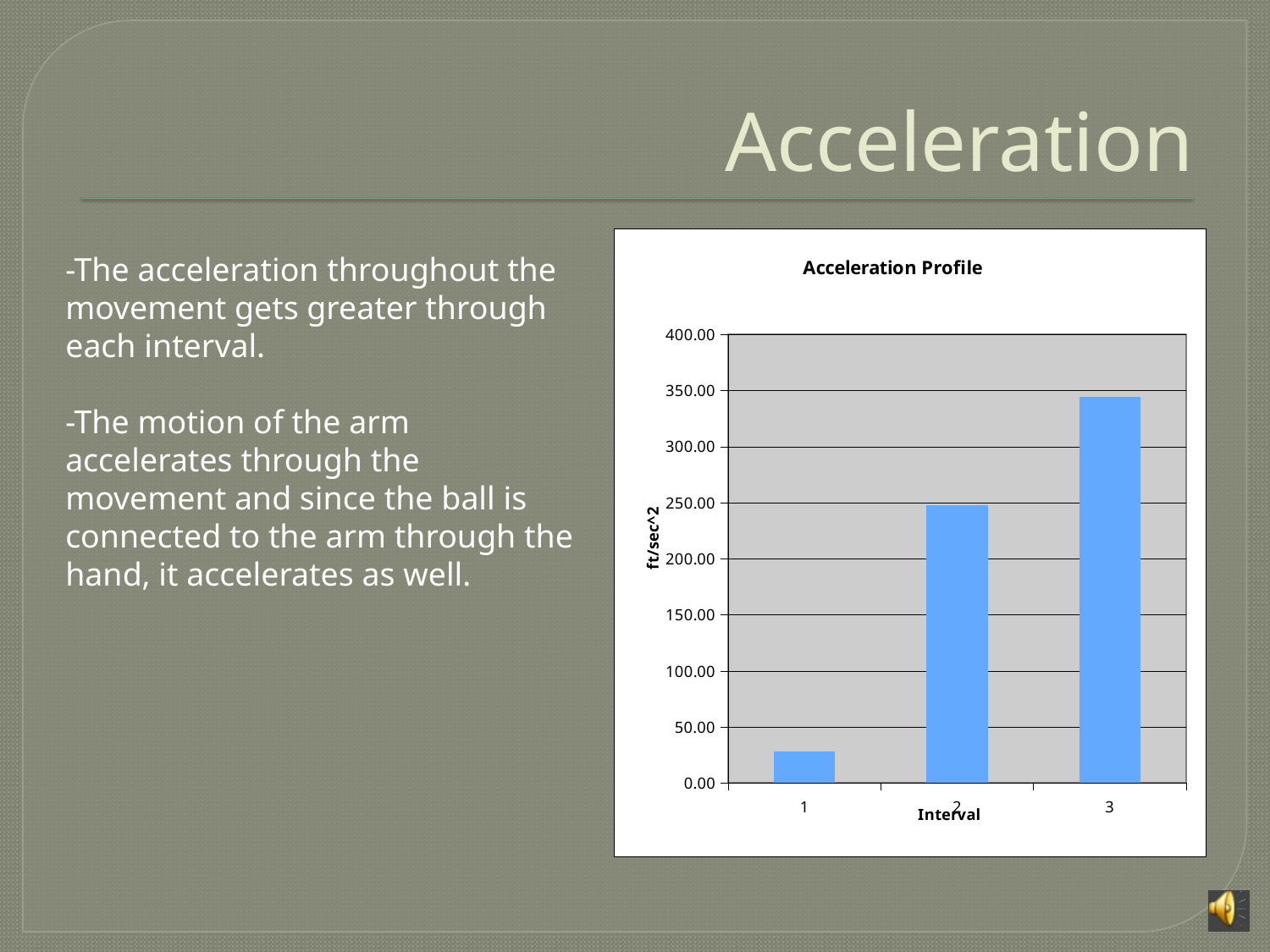
What is the title of the chart? Acceleration Profile Is the value for interval 2 greater or less than 200.00? greater What is the label of the y axis? ft/sec^2 Which interval has the highest acceleration? 3 Is the value for interval 3 greater or less than 300.00? greater Do the values rise or fall from interval 1 to interval 3? rise Is the value for interval 3 greater or less than 350.00? less Which is larger, the value for interval 2 or interval 3? interval 3 How many intervals are plotted in the chart? 3 Which interval has the lowest acceleration? 1 What type of chart is shown on the slide? bar chart